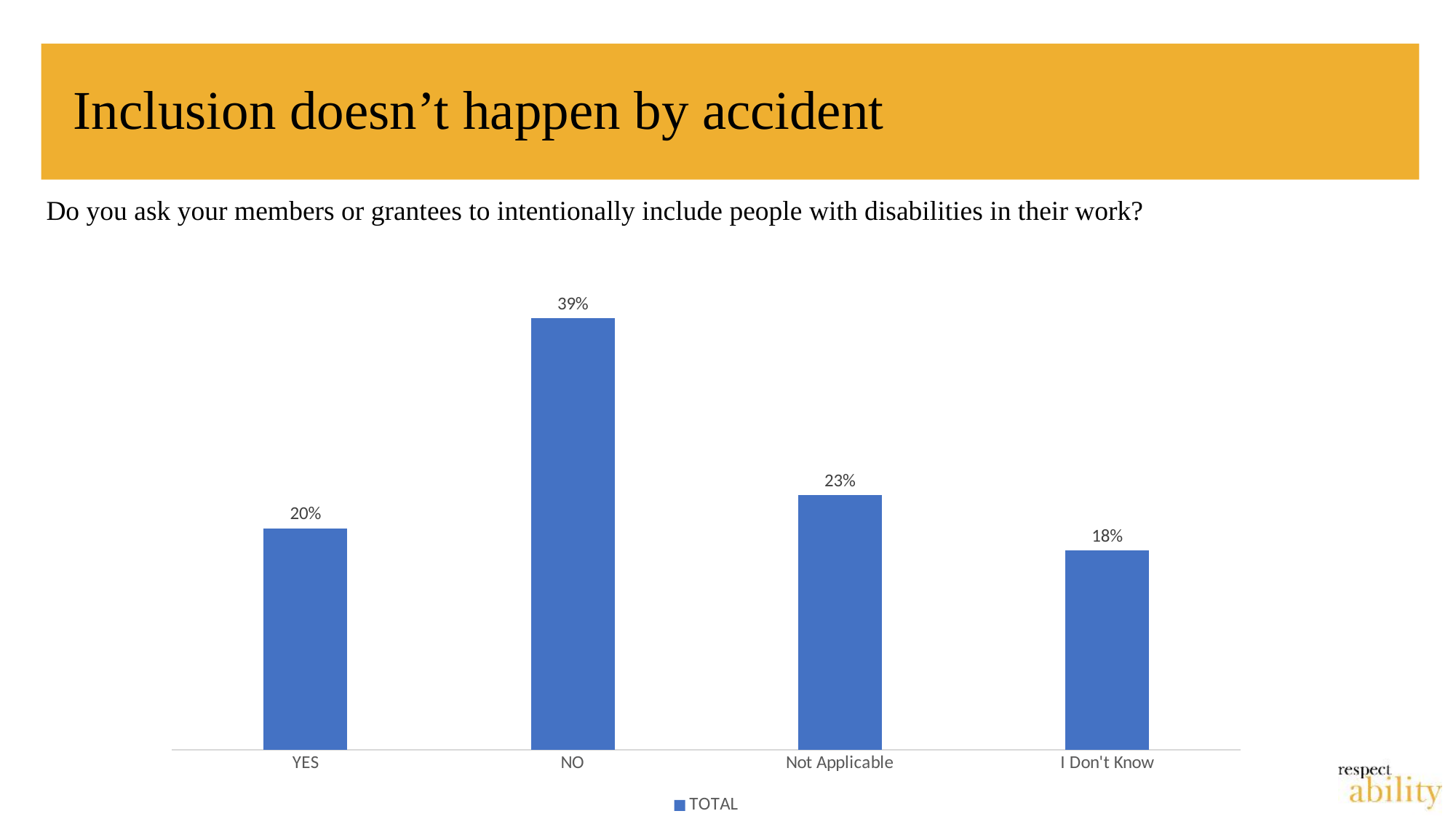
Which is larger, the value for YES or the value for Not Applicable? Not Applicable What is the value for Not Applicable? 23% What is the value for YES? 20% How many categories are shown on the x axis? 4 What is the value for I Don't Know? 18% What kind of chart is shown on the slide? Bar chart What series name does the legend list? TOTAL Which category has the highest value? NO What is the difference between the values for NO and YES? 19% What is the value for NO? 39% Which category has the lowest value? I Don't Know What is the difference between the values for Not Applicable and I Don't Know? 5%